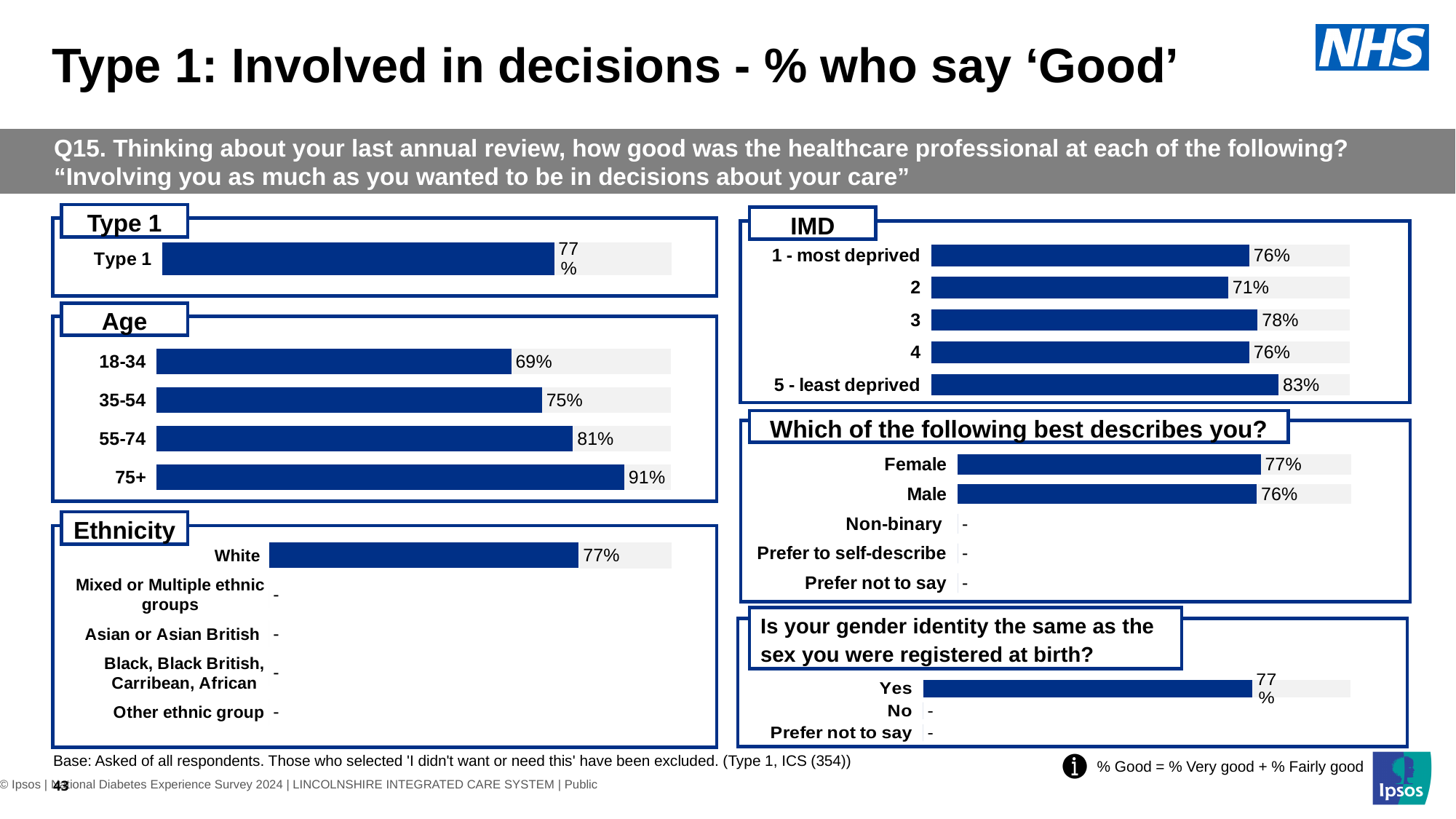
In the IMD chart, which is larger: the value for group 3 or the value for group 2? group 3 In the Age chart, do the values rise or fall as age increases from 18-34 to 75+? rise In the Age chart, what is the difference between the 75+ and 18-34 age groups? 22 percentage points How many categories are shown in the IMD chart? 5 In the Age chart, which age group has the lowest value? 18-34 In the IMD chart, what is the value for IMD group 2? 71% In the 'Which of the following best describes you?' chart, what is the value for Male? 76% In the IMD chart, which category has the highest value? 5 - least deprived In the IMD chart, what is the difference between the values for '5 - least deprived' and '1 - most deprived'? 7 percentage points In the Ethnicity chart, what is the value for White? 77% What kind of chart is used in the Age section? bar chart In the Age chart, what is the value for the 75+ age group? 91%